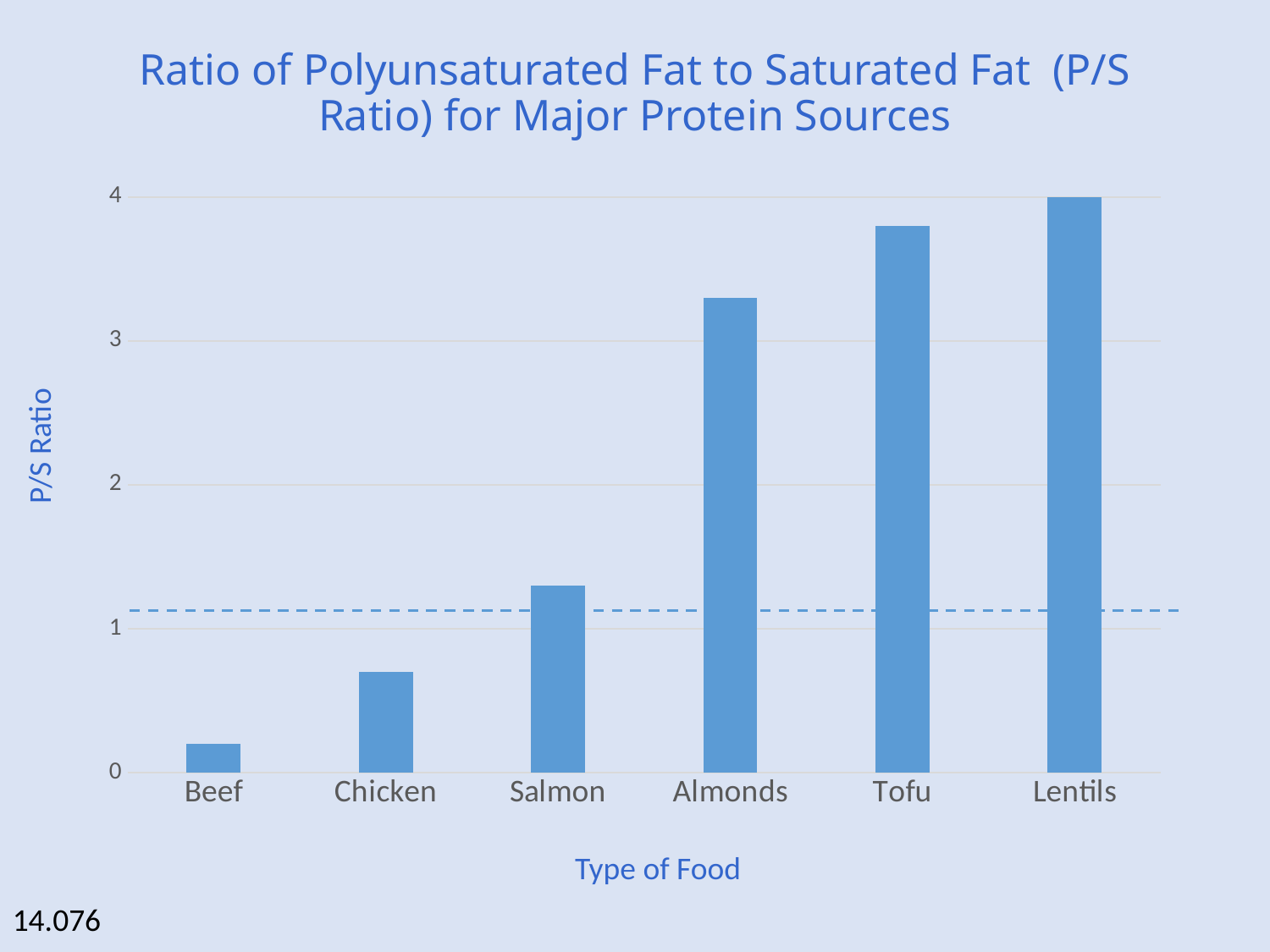
Do the P/S ratio values rise or fall from Beef to Lentils along the x axis? rise How many types of food are plotted on the chart? 6 Which type of food has the highest P/S ratio? Lentils Which has a higher P/S ratio, Tofu or Almonds? Tofu Is the P/S ratio for Chicken greater or less than 1? less Which type of food has the lowest P/S ratio? Beef Is the P/S ratio for Beef greater or less than 1? less Is the P/S ratio for Salmon greater or less than 1? greater What is the title of the vertical axis? P/S Ratio What kind of chart is shown on the slide? bar chart What is the P/S ratio for Lentils? 4